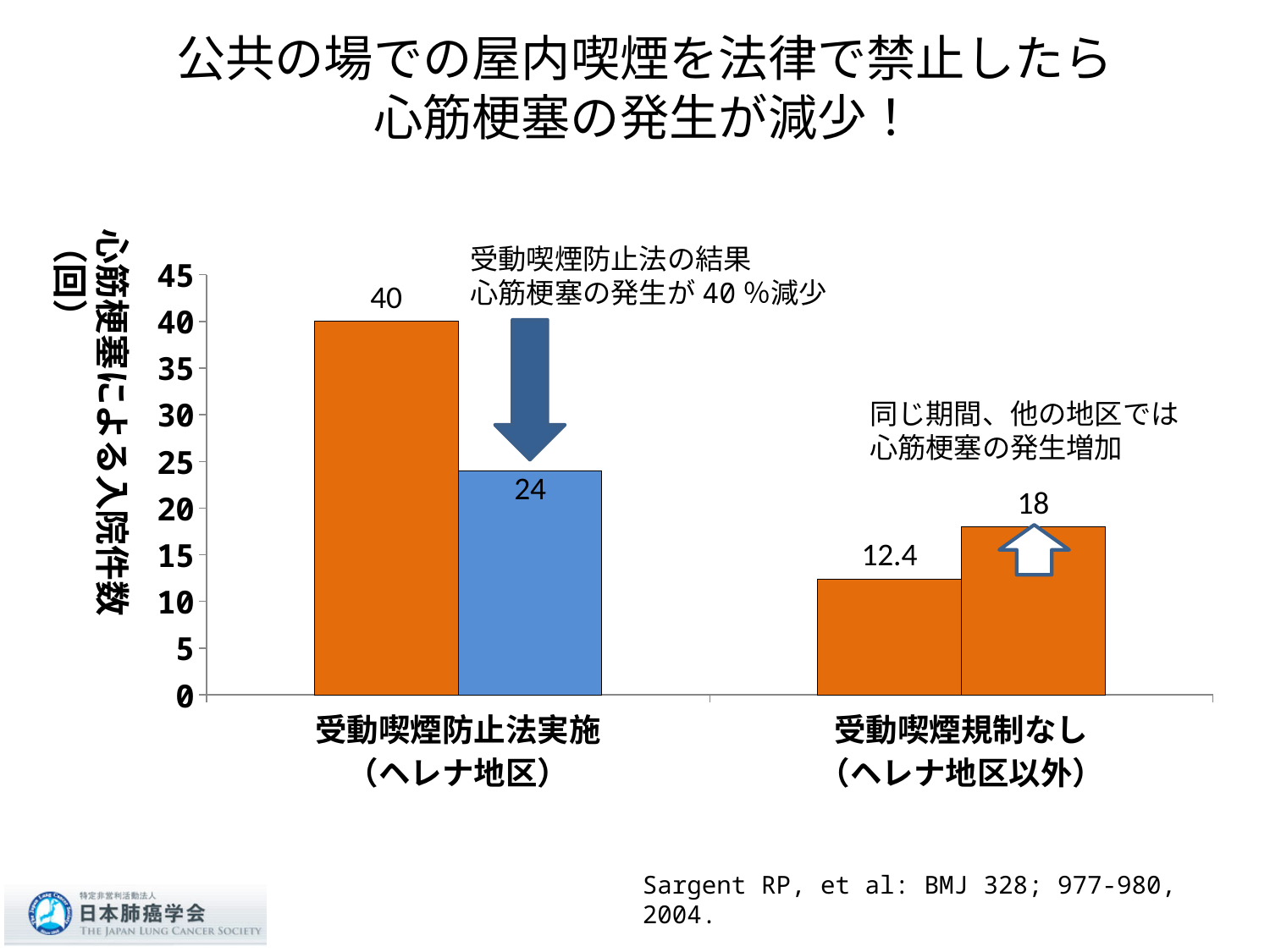
What is the difference between the two bars in the 受動喫煙規制なし（ヘレナ地区以外） category? 5.6 Which bar in the chart has the highest value? the first bar of 受動喫煙防止法実施（ヘレナ地区）, 40 What is the value of the second (right) bar in the 受動喫煙規制なし（ヘレナ地区以外） category? 18 What is the value of the first (left) bar in the 受動喫煙防止法実施（ヘレナ地区） category? 40 Which is larger: the second bar of 受動喫煙防止法実施（ヘレナ地区） or the second bar of 受動喫煙規制なし（ヘレナ地区以外）? the second bar of 受動喫煙防止法実施（ヘレナ地区）, 24 Which bar in the chart has the lowest value? the first bar of 受動喫煙規制なし（ヘレナ地区以外）, 12.4 What kind of chart is shown on the slide? bar chart What is the value of the first (left) bar in the 受動喫煙規制なし（ヘレナ地区以外） category? 12.4 What is the value of the second (right) bar in the 受動喫煙防止法実施（ヘレナ地区） category? 24 What is the label of the y axis of the chart? 心筋梗塞による入院件数（回） How many categories are shown on the x axis of the chart? 2 What is the difference between the two bars in the 受動喫煙防止法実施（ヘレナ地区） category? 16